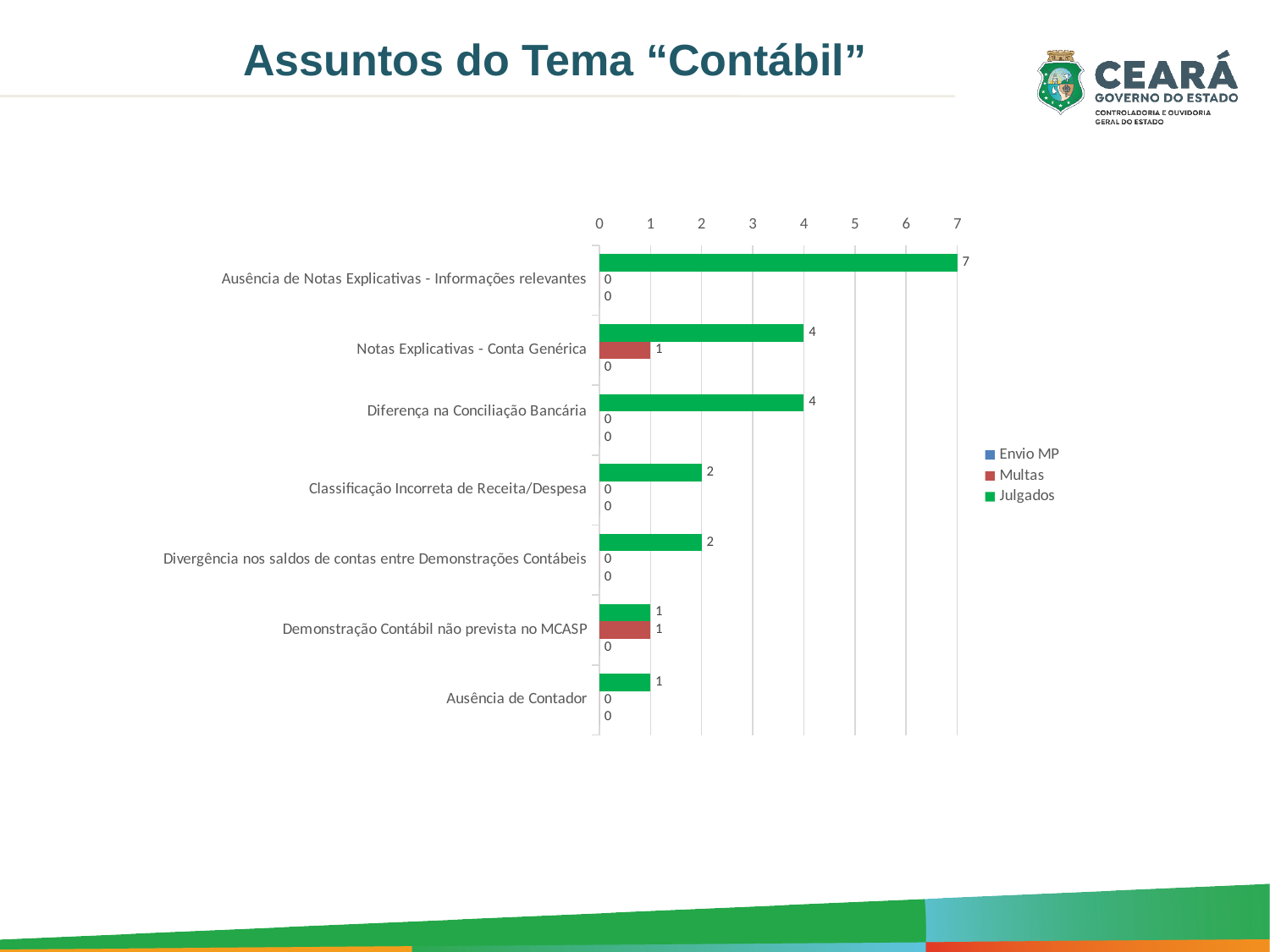
What is the Julgados value for "Diferença na Conciliação Bancária"? 4 How many categories are shown on the chart? 7 What is the Multas value for "Notas Explicativas - Conta Genérica"? 1 What is the Multas value for "Demonstração Contábil não prevista no MCASP"? 1 Which is larger: the Julgados value for "Classificação Incorreta de Receita/Despesa" or for "Diferença na Conciliação Bancária"? Diferença na Conciliação Bancária What is the difference between the Julgados values for "Ausência de Notas Explicativas - Informações relevantes" and "Notas Explicativas - Conta Genérica"? 3 What type of chart is shown on the slide? bar chart Which category has the highest Julgados value? Ausência de Notas Explicativas - Informações relevantes What is the Julgados value for "Ausência de Notas Explicativas - Informações relevantes"? 7 What is the Envio MP value for "Ausência de Contador"? 0 How many series does the legend list? 3 What is the title of the slide containing the chart? Assuntos do Tema "Contábil"